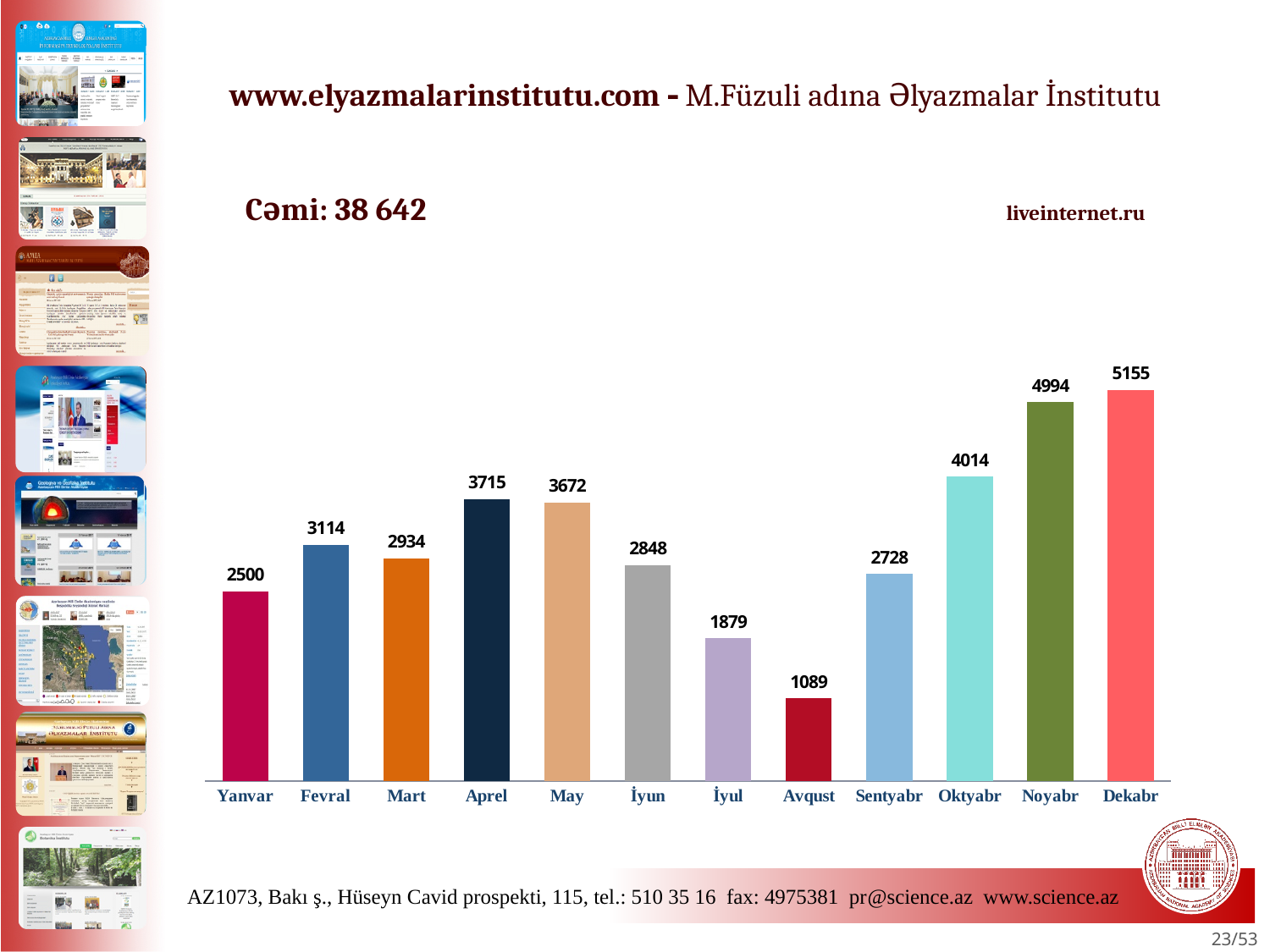
Which month has the lowest value? Avqust How many months are shown on the chart? 12 What is the difference between the values for Aprel and May? 43 Do the values rise or fall from Sentyabr to Dekabr? rise What is the value for Avqust? 1089 What total (Cəmi) is stated on the slide? 38 642 What is the value for Yanvar? 2500 What kind of chart is shown on the slide? bar chart Which is larger, the value for Fevral or the value for Mart? Fevral What is the value for Oktyabr? 4014 What is the difference between the values for Dekabr and Noyabr? 161 Which month has the highest value? Dekabr